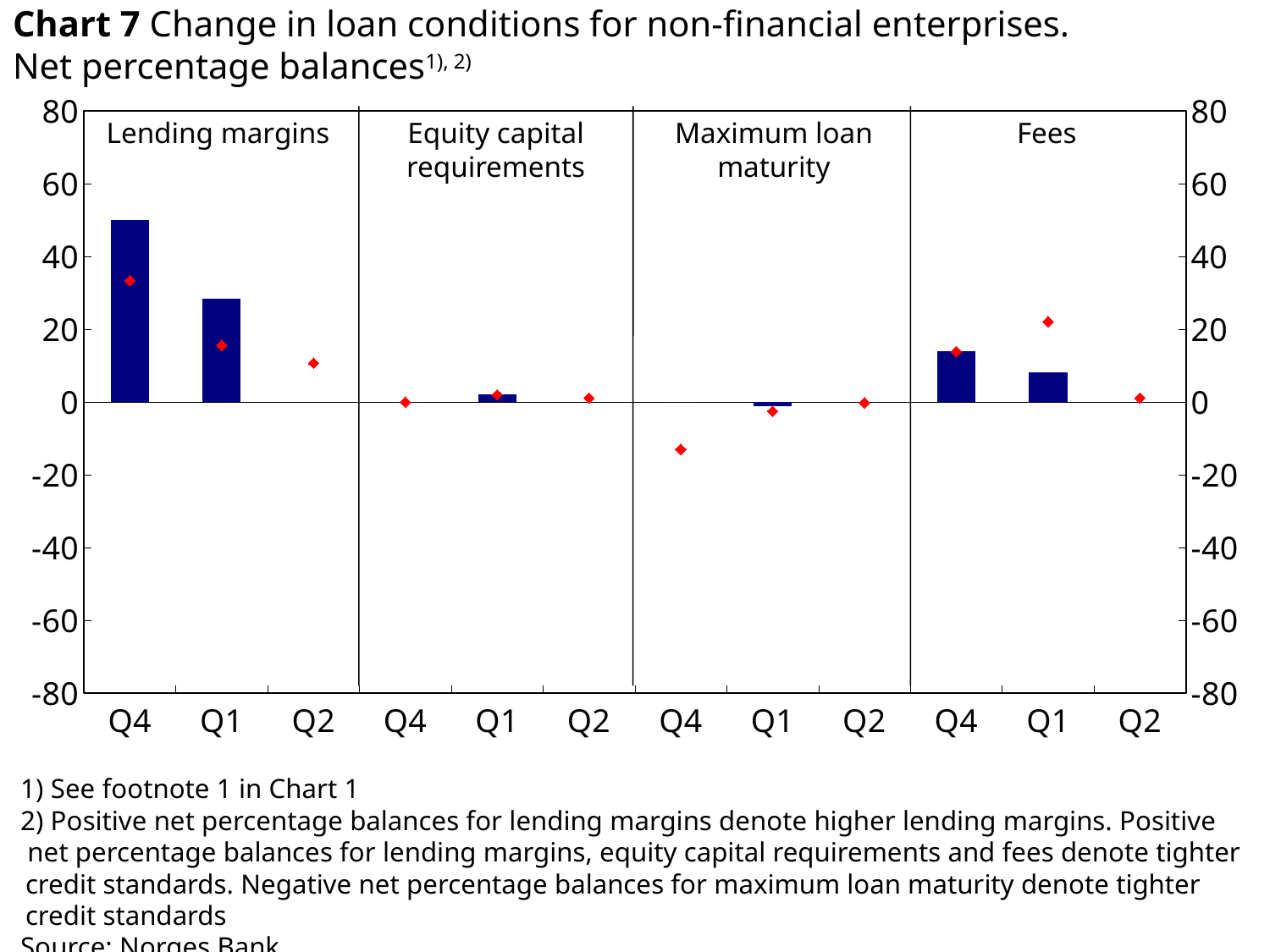
What is the maximum value shown on the y axis of Chart 7? 80 In the Fees panel, is the bar for Q1 greater or less than 20? less What kind of chart is Chart 7? bar chart In the Fees panel, which bar is taller, Q4 or Q1? Q4 How many loan condition panels are shown in Chart 7? 4 How many quarters are shown on the x axis within each panel of Chart 7? 3 Which panel contains the tallest bar in Chart 7? Lending margins In the Lending margins panel, is the bar for Q1 greater or less than 20? greater Do the bars in the Lending margins panel rise or fall from Q4 to Q1? fall In the Fees panel, is the bar for Q4 greater or less than 20? less In the Lending margins panel, which bar is taller, Q4 or Q1? Q4